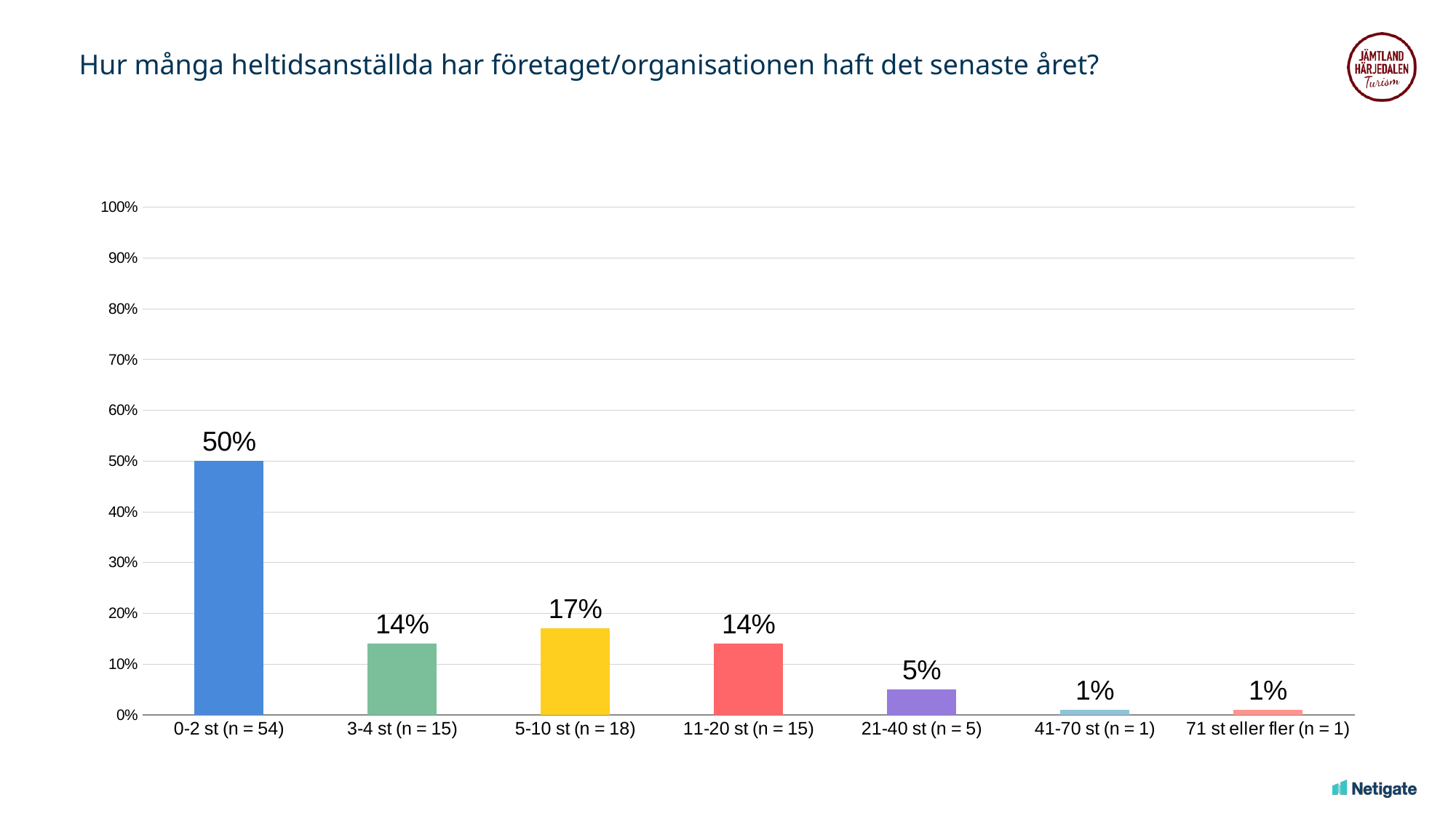
What is the value for the category "0-2 st (n = 54)"? 50% What is the difference between the values for "0-2 st (n = 54)" and "5-10 st (n = 18)"? 33% What is the value for the category "41-70 st (n = 1)"? 1% How many categories are shown on the x axis? 7 What is the difference between the values for "5-10 st (n = 18)" and "3-4 st (n = 15)"? 3% What is the title of the chart? Hur många heltidsanställda har företaget/organisationen haft det senaste året? Is the value for "0-2 st (n = 54)" greater or less than 40%? greater Which category has the highest value? 0-2 st (n = 54) Which is larger, the value for "5-10 st (n = 18)" or the value for "21-40 st (n = 5)"? 5-10 st (n = 18) What is the value for the category "21-40 st (n = 5)"? 5% What kind of chart is shown on the slide? bar chart What is the value for the category "5-10 st (n = 18)"? 17%